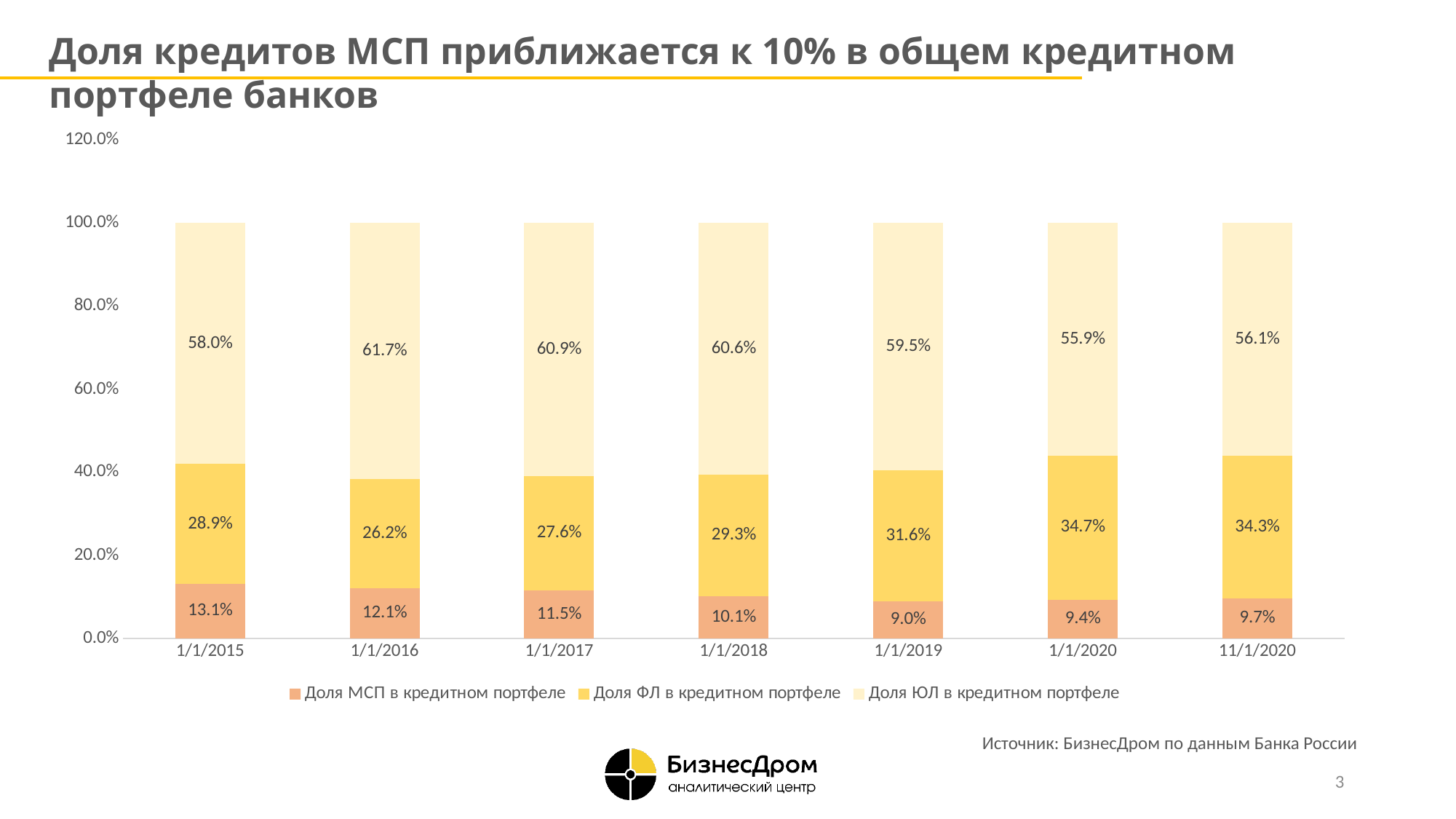
What is the value of Доля ЮЛ в кредитном портфеле for 1/1/2016? 61.7% What is the value of Доля МСП в кредитном портфеле for 1/1/2015? 13.1% On which date is Доля ФЛ в кредитном портфеле the highest? 1/1/2020 On which date is Доля МСП в кредитном портфеле the highest? 1/1/2015 How many dates are shown on the x axis? 7 What kind of chart is shown on the slide? Stacked bar chart What is the value of Доля ФЛ в кредитном портфеле for 11/1/2020? 34.3% What is the total of the stacked bar for 1/1/2015? 100.0% How many series does the legend list? 3 Which is larger: Доля ФЛ в кредитном портфеле on 1/1/2018 or on 1/1/2017? 1/1/2018 What is the difference between Доля МСП в кредитном портфеле on 1/1/2015 and on 1/1/2019? 4.1 percentage points On which date is Доля МСП в кредитном портфеле the lowest? 1/1/2019